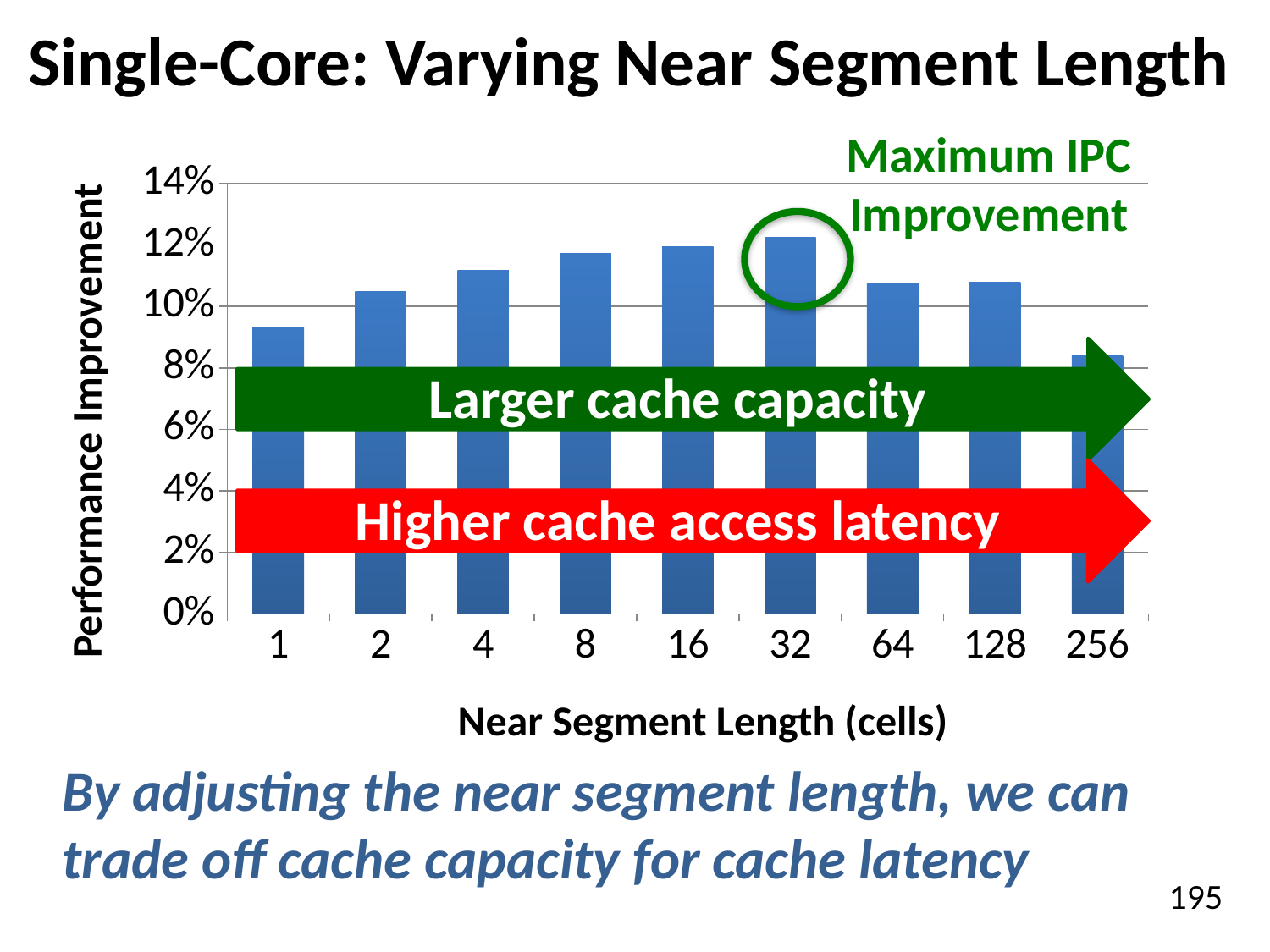
Is the performance improvement for a near segment length of 256 greater or less than 10%? less Which has a larger performance improvement: a near segment length of 32 or 256? 32 How many near segment lengths are plotted on the x axis? 9 Which near segment length has the lowest performance improvement? 256 Is the performance improvement for a near segment length of 8 greater or less than 12%? less What kind of chart is shown on the slide? bar chart Which has a larger performance improvement: a near segment length of 16 or 1? 16 How does the performance improvement change as the near segment length increases from 1 to 32? It rises What is the label of the x axis? Near Segment Length (cells) Is the performance improvement for a near segment length of 64 greater or less than 10%? greater Which near segment length has the highest performance improvement? 32